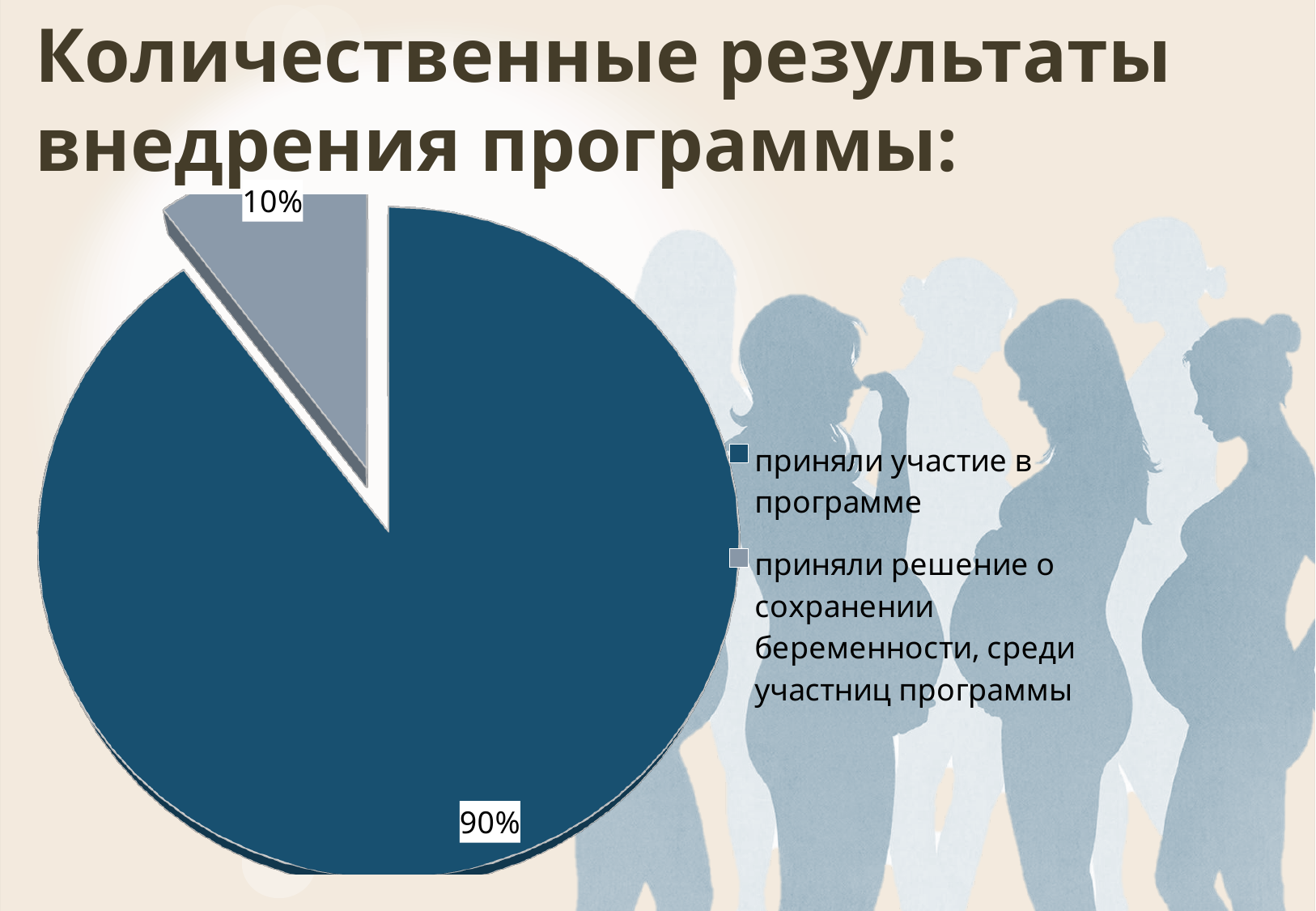
What share of the pie is labelled "приняли участие в программе"? 90% What is the difference in percentage points between the "приняли участие в программе" slice and the "приняли решение о сохранении беременности" slice? 80 Which is larger: the "приняли участие в программе" slice or the "приняли решение о сохранении беременности" slice? приняли участие в программе What kind of chart is shown on the slide? pie chart What colour is the slice labelled 10%? grey Which slice of the pie is the smallest? приняли решение о сохранении беременности, среди участниц программы How many slices does the pie chart have? 2 What is the title of the slide containing the pie chart? Количественные результаты внедрения программы: How many entries does the legend list? 2 Which slice of the pie is the largest? приняли участие в программе What share of the pie is labelled "приняли решение о сохранении беременности, среди участниц программы"? 10%